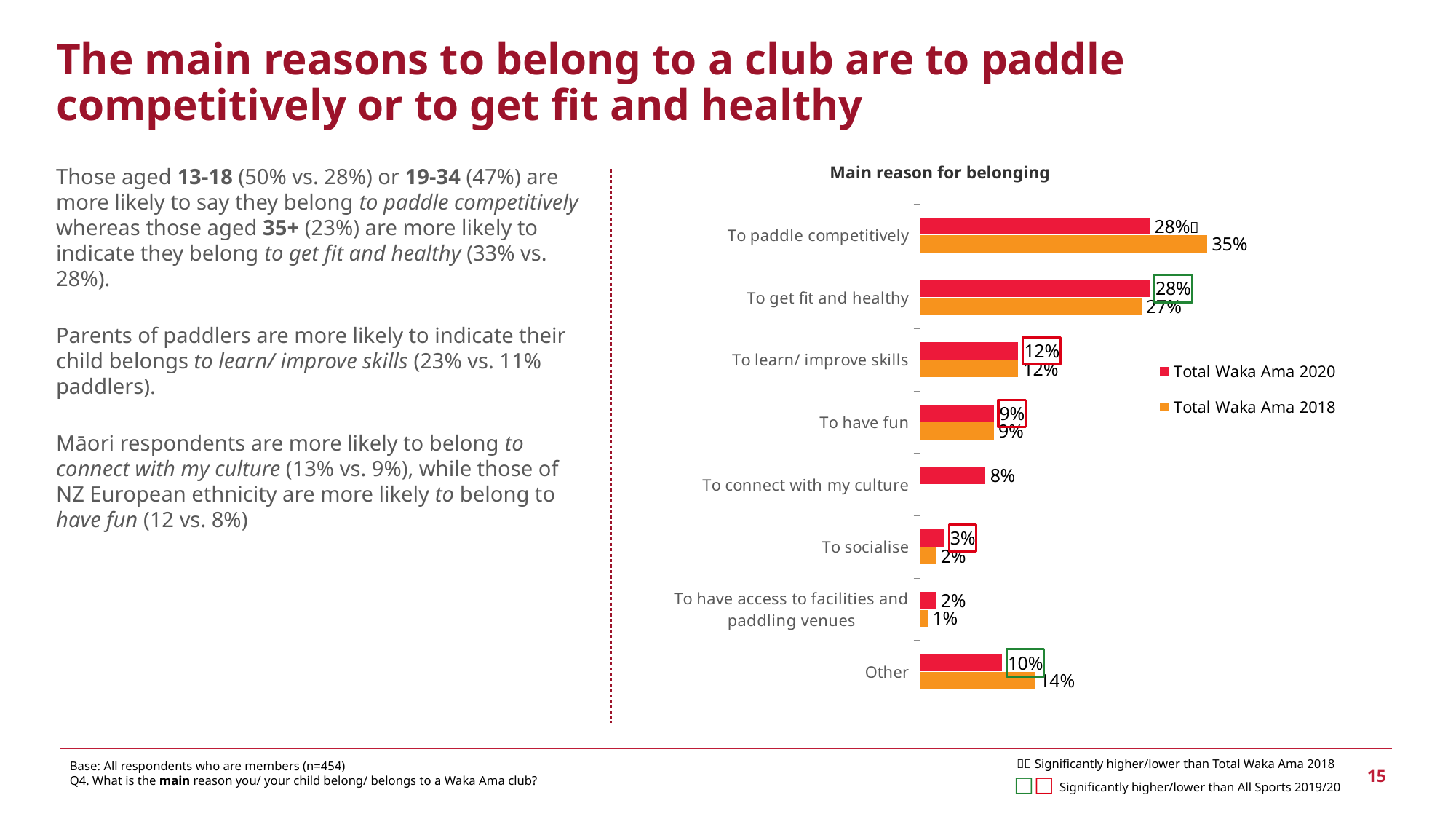
What is the Total Waka Ama 2018 value for 'To paddle competitively'? 35% What is the title of the chart? Main reason for belonging What is the Total Waka Ama 2018 value for 'To socialise'? 2% How many series does the chart legend list? 2 Which category has the lowest Total Waka Ama 2020 value? To have access to facilities and paddling venues For 'Other', which series has the larger value, Total Waka Ama 2020 or Total Waka Ama 2018? Total Waka Ama 2018 What is the Total Waka Ama 2020 value for 'To get fit and healthy'? 28% What is the difference between the Total Waka Ama 2018 and Total Waka Ama 2020 values for 'To paddle competitively'? 7% Which category has the highest Total Waka Ama 2018 value? To paddle competitively What is the Total Waka Ama 2020 value for 'To connect with my culture'? 8% How many reason categories are shown on the chart? 8 What type of chart is shown on the slide? bar chart